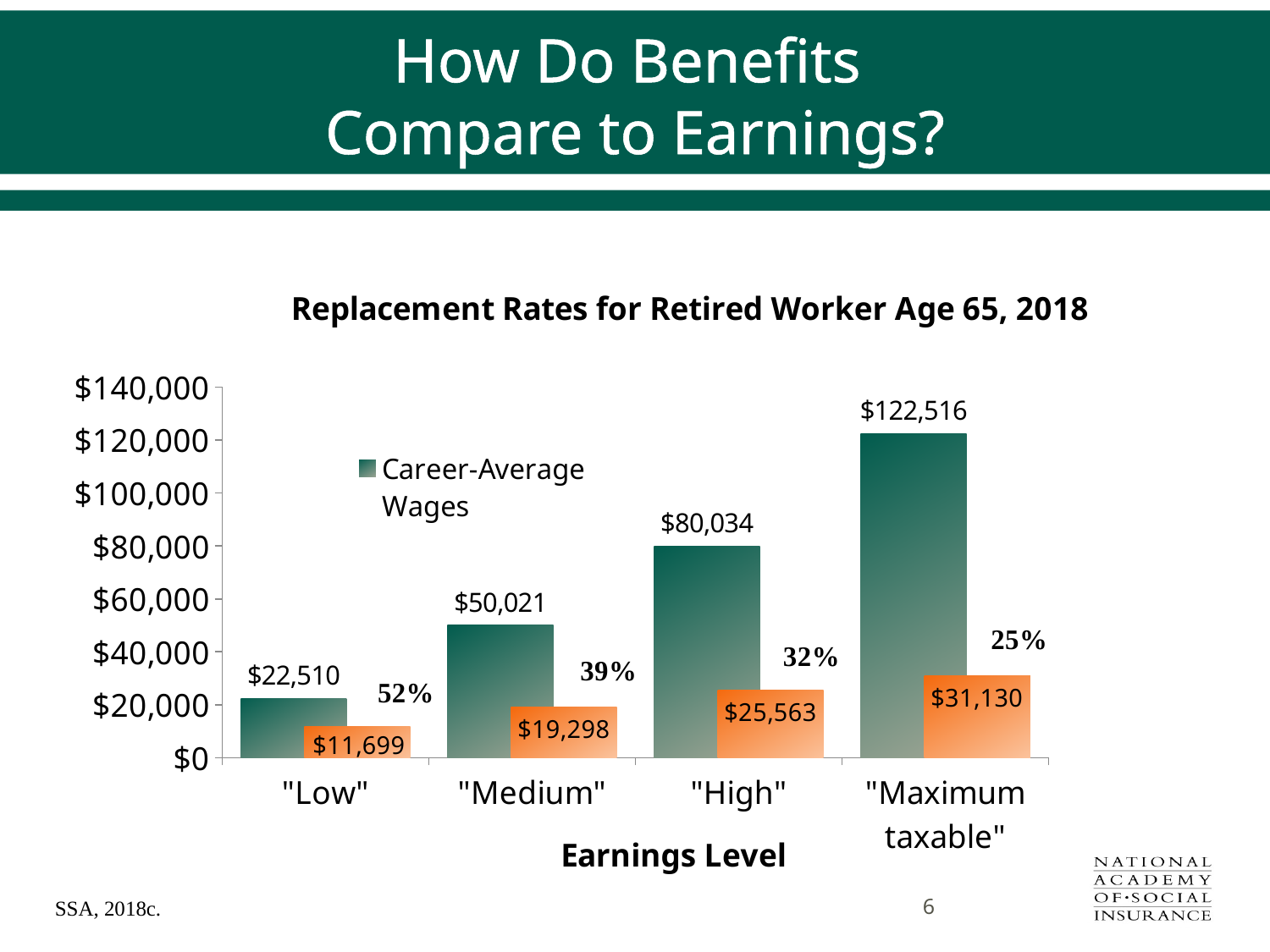
Which is larger: the Career-Average Wages for "Low" or the orange bar value for "Maximum taxable"? Orange bar value for "Maximum taxable" How many series does the legend list? 1 Do the replacement rate percentages rise or fall as the earnings level increases from "Low" to "Maximum taxable"? Fall Which earnings level has the highest Career-Average Wages? "Maximum taxable" What is the Career-Average Wages value for the "Maximum taxable" earnings level? $122,516 What is the Career-Average Wages value for the "Medium" earnings level? $50,021 What is the difference between the Career-Average Wages for "High" and "Medium"? $30,013 What kind of chart is shown on the slide? Bar chart How many earnings levels are shown on the x axis? 4 What value is printed on the orange bar for the "High" earnings level? $25,563 What replacement rate percentage is shown for the "Low" earnings level? 52% Which earnings level has the lowest value on its orange bar? "Low"